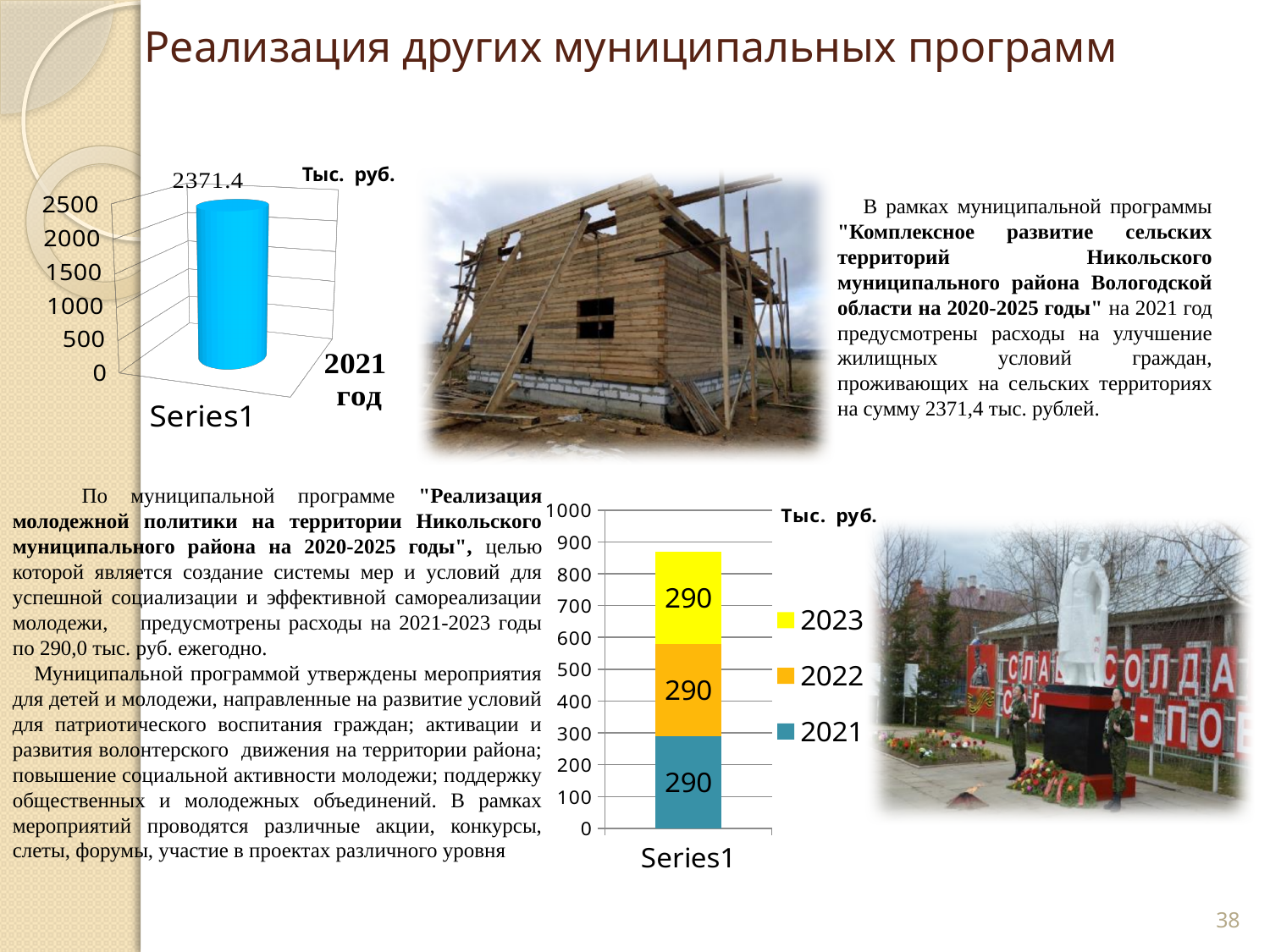
In the top-left chart, is the value for 2021 год greater or less than 2000? greater In the bottom stacked bar chart, what is the value for 2023? 290 In the top-left chart, what value is printed on the bar for 2021 год? 2371.4 What unit label is shown above the top-left chart? Тыс. руб. In the bottom stacked bar chart, what is the difference between the values for 2022 and 2021? 0 In the bottom stacked bar chart, what is the total of the stacked bar for Series1? 870 In the bottom stacked bar chart, what is the value for 2021? 290 In the bottom stacked bar chart, which colour represents 2023 in the legend? yellow What kind of chart is the bottom chart on the slide? stacked bar chart How many series does the legend of the bottom stacked bar chart list? 3 In the bottom stacked bar chart, is the total height of the stacked bar greater or less than 900? less What kind of chart is the top-left chart on the slide? bar chart